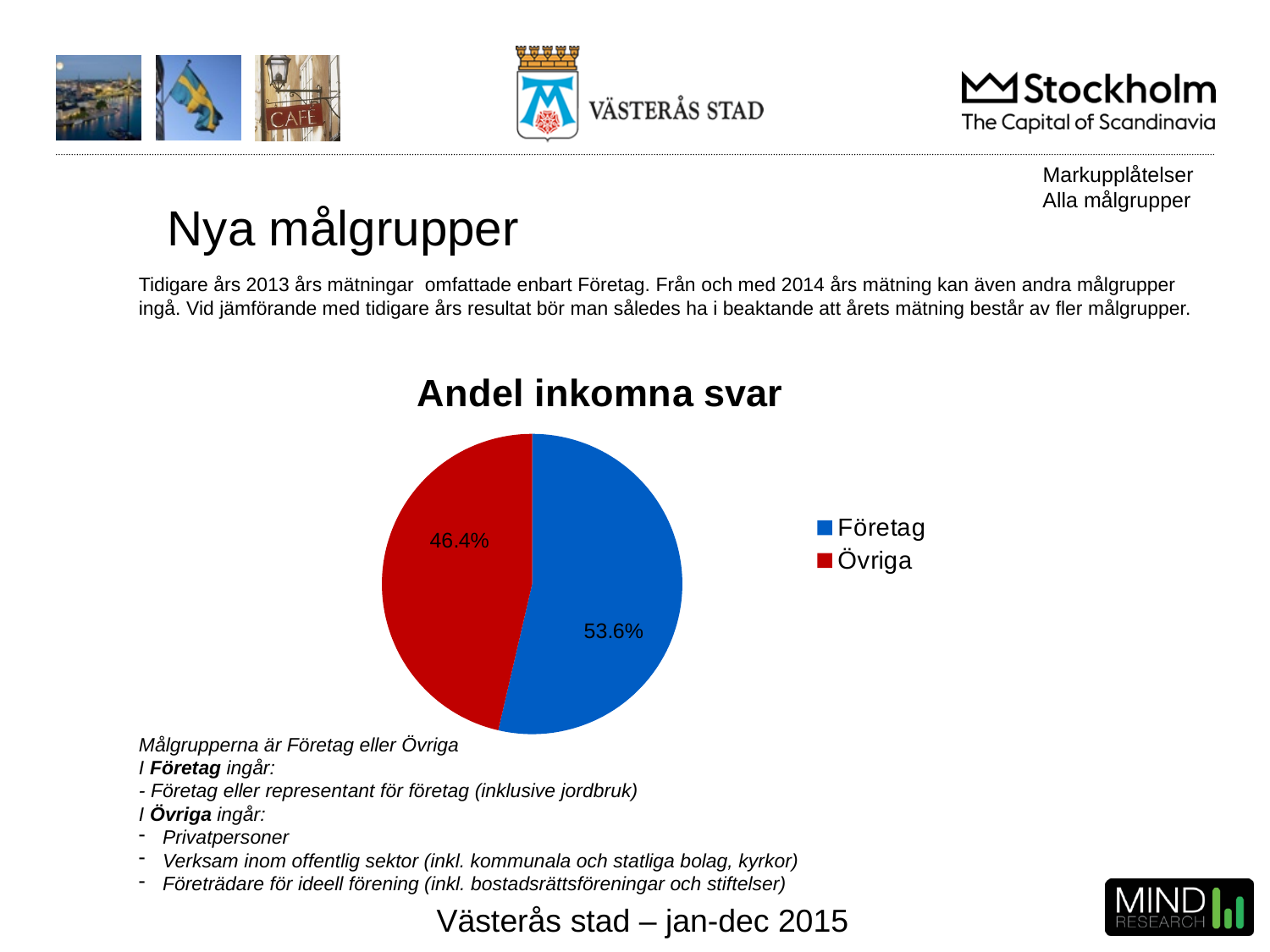
How many slices does the pie chart have? 2 Is the share for Företag greater or less than 50%? greater Which category has the smallest slice in the pie chart? Övriga What kind of chart is shown on the slide? Pie chart What is the share for Övriga in the pie chart? 46.4% What is the share for Företag in the pie chart? 53.6% Which is larger, the share for Företag or the share for Övriga? Företag How many entries does the legend list? 2 Which category has the largest slice in the pie chart? Företag What is the difference in percentage points between Företag and Övriga? 7.2 What is the title of the chart? Andel inkomna svar What colour is the Övriga slice in the pie chart? Red